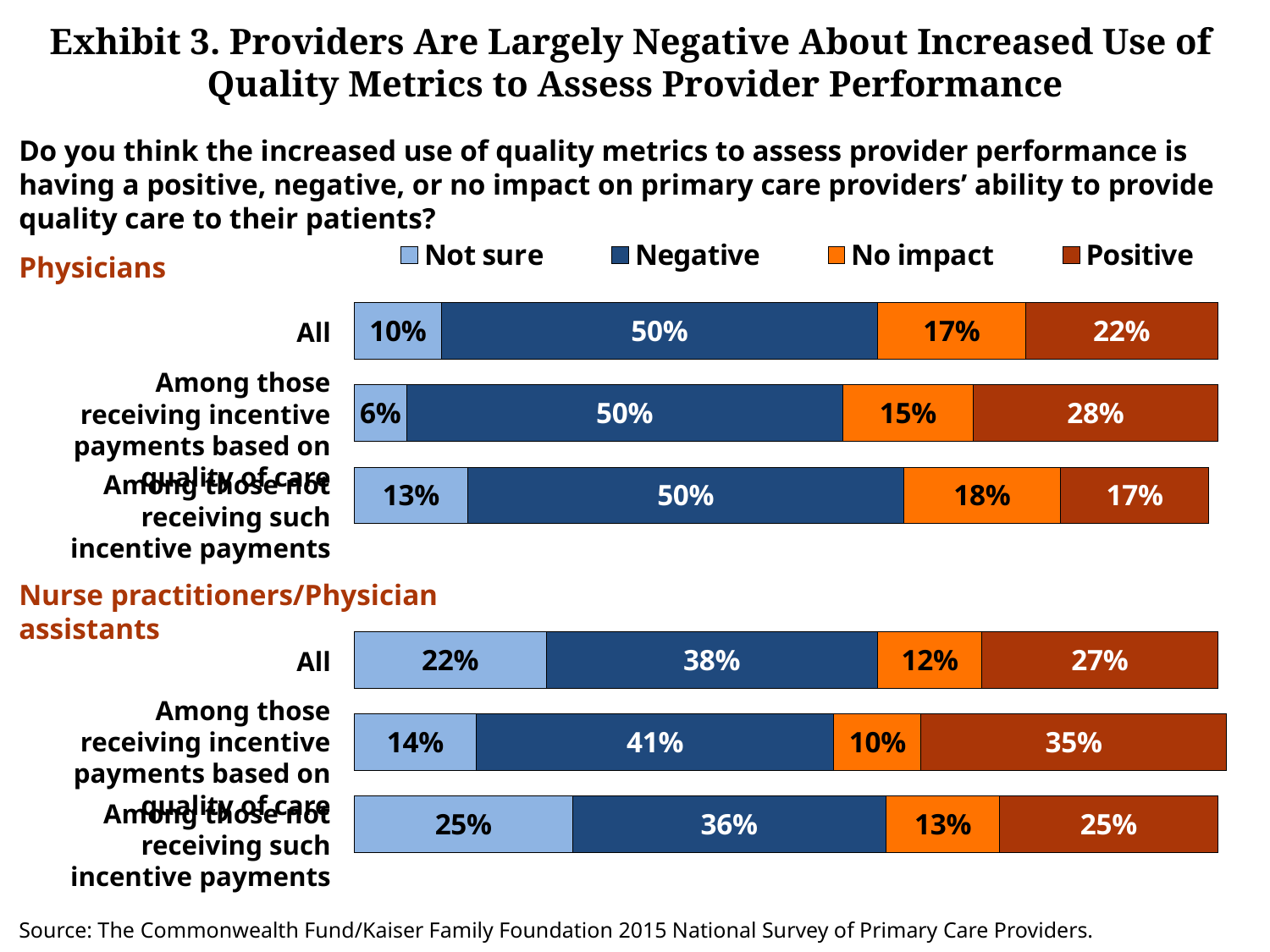
In the Physicians chart, what is the Not sure value for those not receiving incentive payments? 13% How many bars are shown in the Physicians chart? 3 In the Nurse practitioners/Physician assistants chart, what is the total of the four segments in the All bar? 99% Which is larger: the Not sure value for All in the Physicians chart or the Not sure value for All in the Nurse practitioners/Physician assistants chart? Nurse practitioners/Physician assistants (22%) In the Physicians chart, which group has the highest Positive value? Among those receiving incentive payments based on quality of care In the Physicians chart, how many percentage points higher is the Positive value for those receiving incentive payments than for those not receiving such payments? 11 percentage points In the Nurse practitioners/Physician assistants chart, what is the No impact value for the All bar? 12% In the Nurse practitioners/Physician assistants chart, which group has the lowest No impact value? Among those receiving incentive payments based on quality of care In the Physicians chart, what percentage of all physicians said the increased use of quality metrics is having a negative impact? 50% How many series does the legend list? 4 What type of chart is used on this slide? Stacked bar chart In the Nurse practitioners/Physician assistants chart, what is the Positive value for those receiving incentive payments based on quality of care? 35%